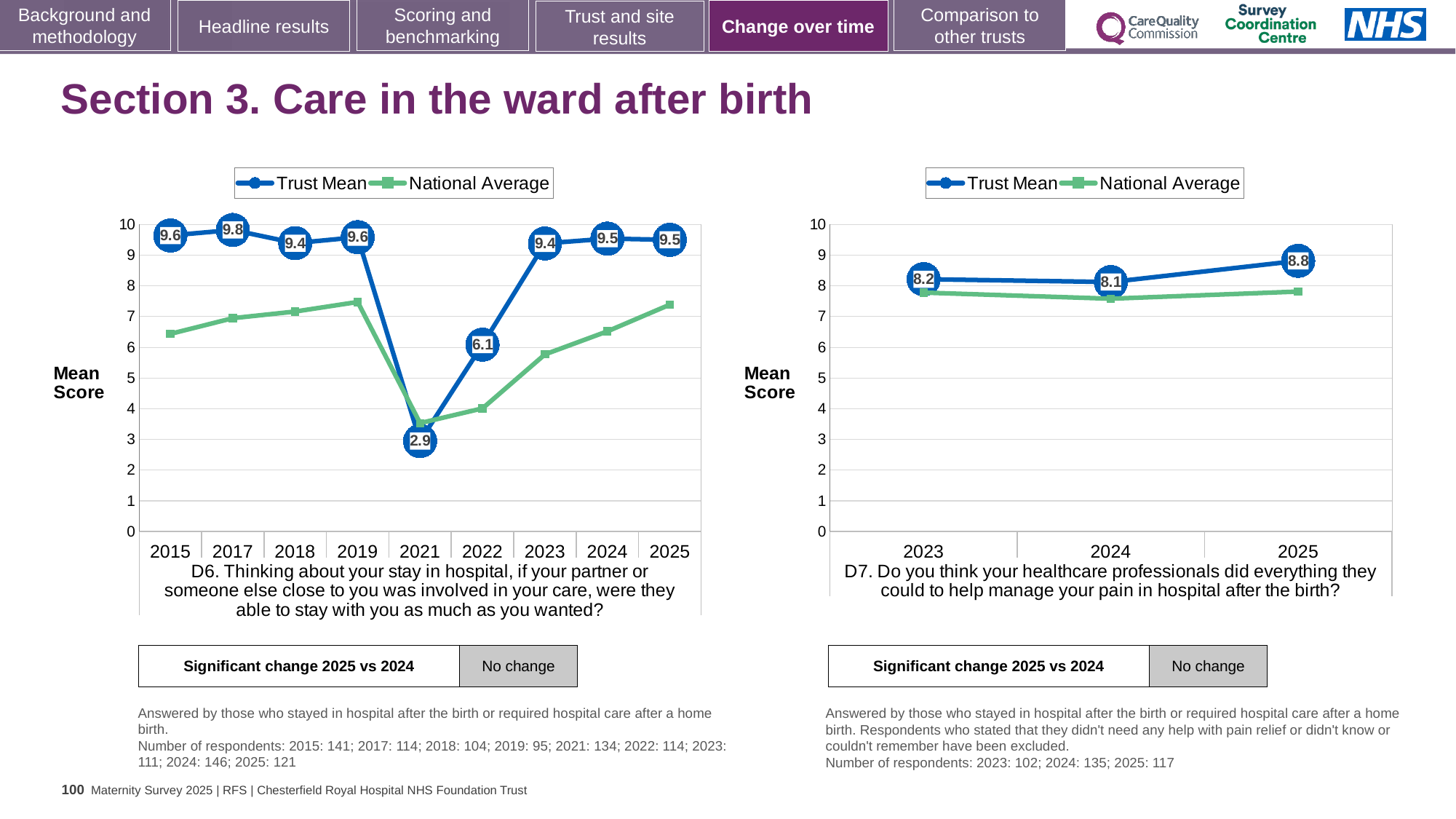
In the D6 chart on the left, which year has the lowest Trust Mean? 2021 In the D7 chart on the right, which year has the lowest Trust Mean? 2024 How many series does the legend of the D7 chart on the right list? 2 In the D6 chart on the left, what is the Trust Mean for 2022? 6.1 In the D6 chart on the left, what is the Trust Mean for 2021? 2.9 In the D6 chart on the left, which year has the highest Trust Mean? 2017 In the D6 chart on the left, how many years are shown on the x axis? 9 In the D7 chart on the right, what is the difference between the Trust Mean for 2025 and the Trust Mean for 2023? 0.6 In the D6 chart on the left, is the National Average for 2015 greater or less than 7? less In the D6 chart on the left, what is the difference between the Trust Mean for 2022 and the Trust Mean for 2021? 3.2 In the D7 chart on the right, is the Trust Mean or the National Average higher in 2025? Trust Mean In the D7 chart on the right, what is the Trust Mean for 2025? 8.8